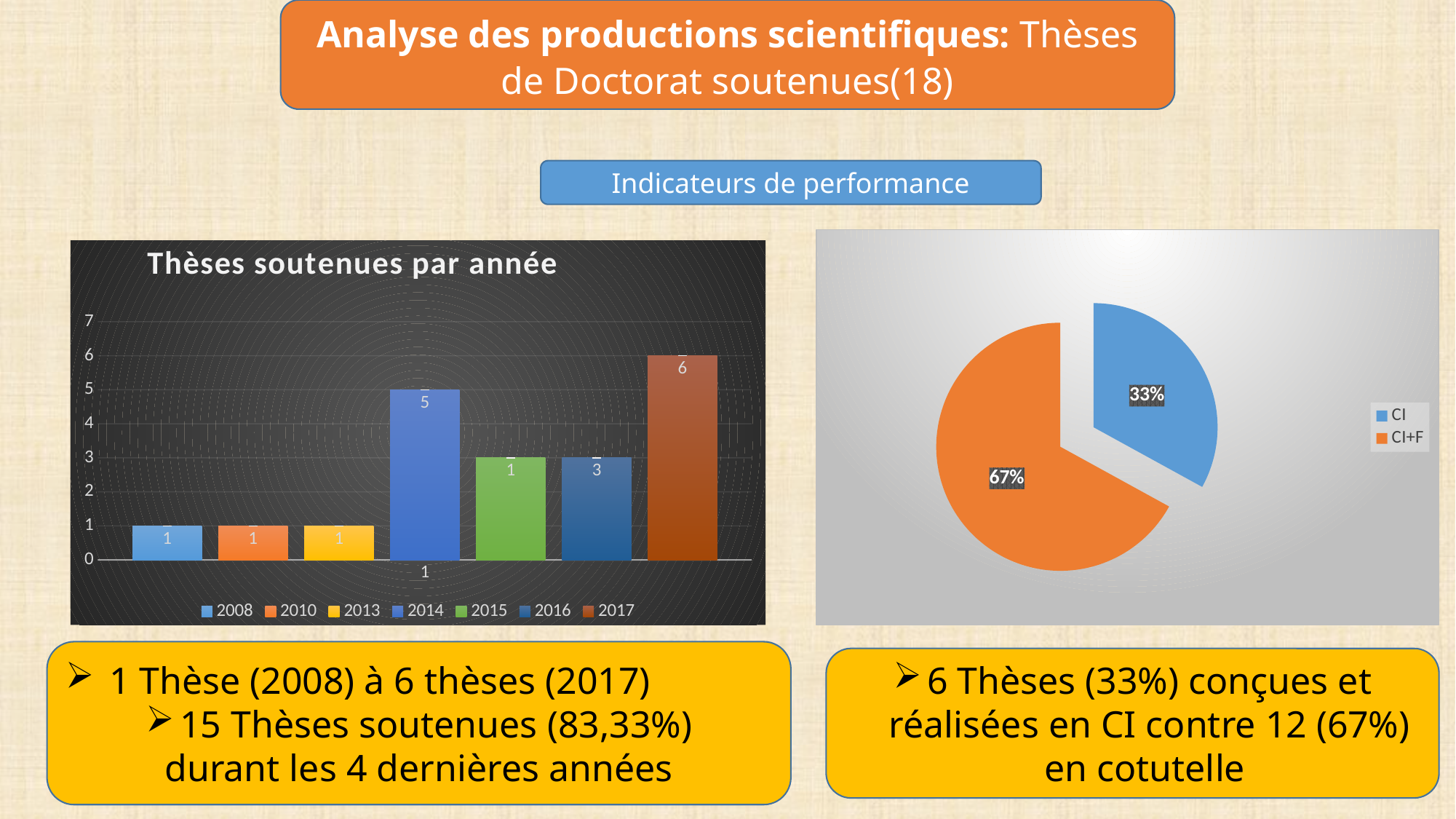
In the pie chart on the right, which slice is the largest? CI+F In the chart 'Thèses soutenues par année', what is the value for 2008? 1 How many entries does the legend of the chart 'Thèses soutenues par année' list? 7 In the chart 'Thèses soutenues par année', which year has the highest value? 2017 How many slices does the pie chart on the right have? 2 In the pie chart on the right, what share does CI have? 33% In the chart 'Thèses soutenues par année', what is the value for 2014? 5 In the chart 'Thèses soutenues par année', what is the value for 2016? 3 In the chart 'Thèses soutenues par année', what is the difference between the values for 2017 and 2014? 1 In the chart 'Thèses soutenues par année', which is larger, the value for 2014 or the value for 2016? 2014 What kind of chart is 'Thèses soutenues par année'? bar chart In the chart 'Thèses soutenues par année', what is the value for 2017? 6